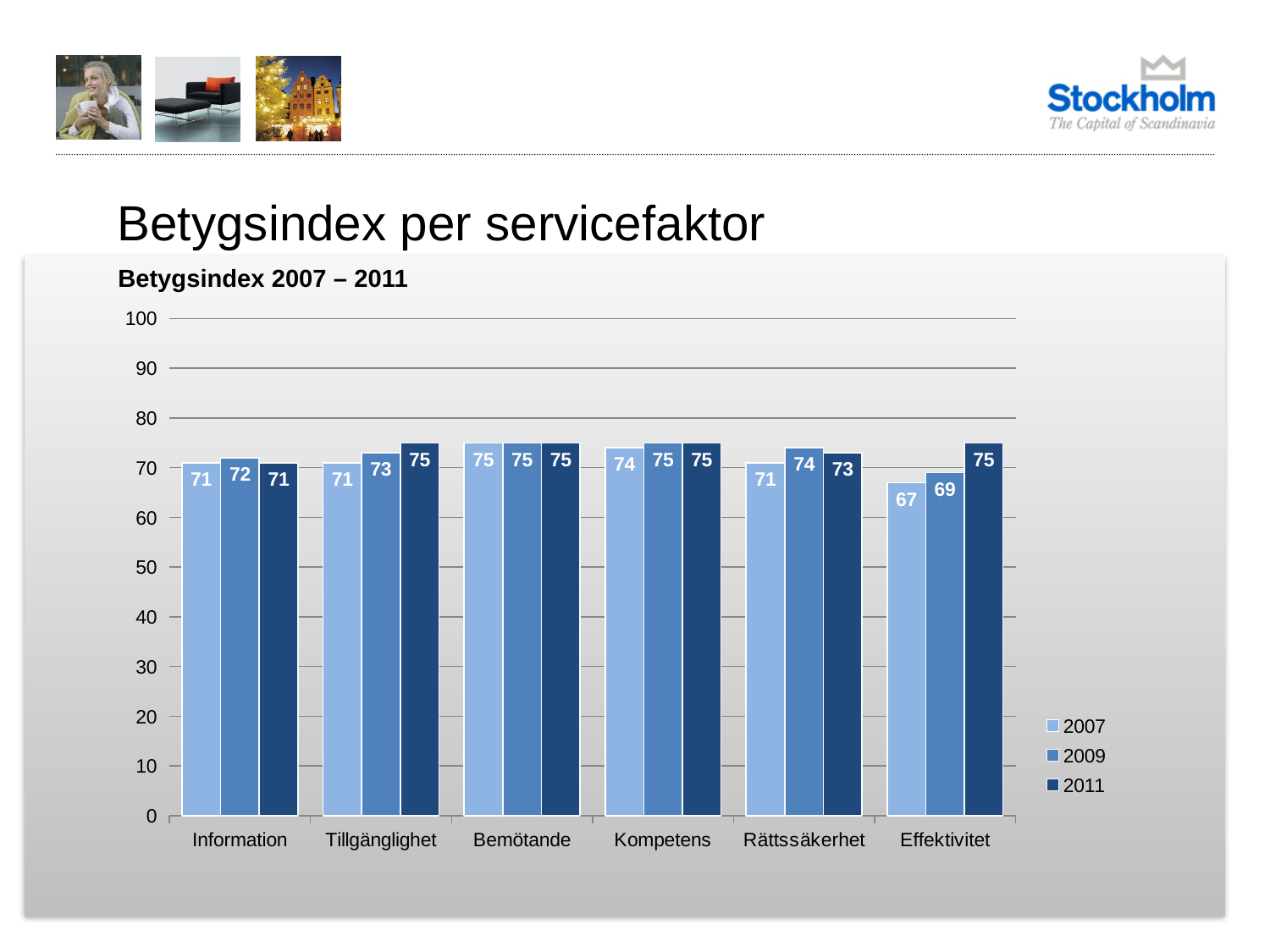
What is the difference between the 2011 and 2007 values for Effektivitet? 8 Is the value for Bemötande in 2011 greater or less than 80? less What is the value for Rättssäkerhet in 2011? 73 What kind of chart is shown? bar chart What is the value for Effektivitet in 2007? 67 Which category has the lowest value in 2007? Effektivitet What is the title shown above the chart? Betygsindex 2007 – 2011 What is the difference between the 2011 values for Tillgänglighet and Rättssäkerhet? 2 Which is larger: the 2009 value for Effektivitet or the 2009 value for Information? Information What is the value for Information in 2009? 72 How many series does the legend list? 3 How many categories are shown on the x axis? 6